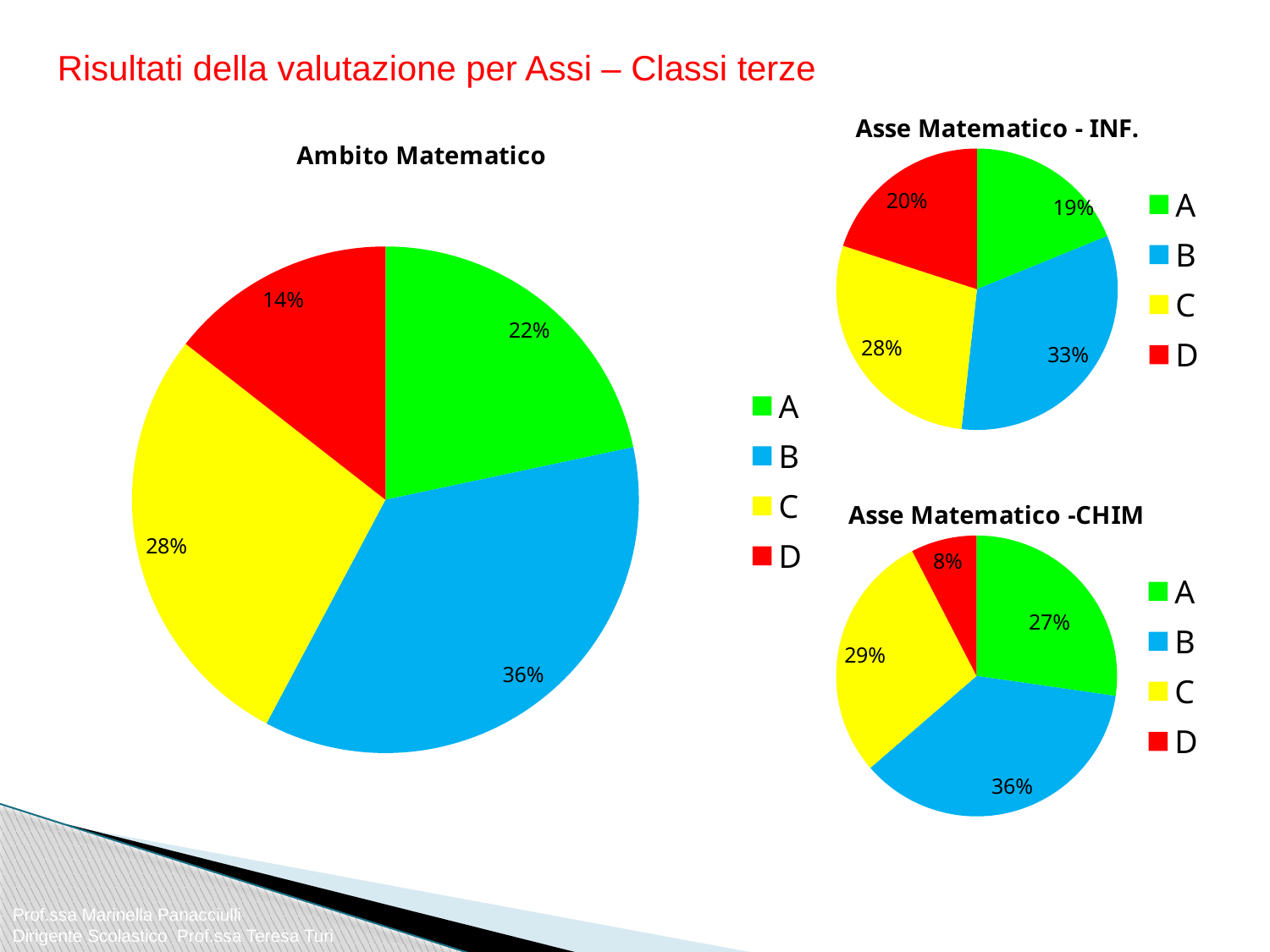
What kind of chart is 'Ambito Matematico'? Pie chart In the 'Asse Matematico - INF.' chart, what share does category D have? 20% In the 'Ambito Matematico' chart, which category has the smallest slice? D In the 'Ambito Matematico' chart, what colour is the slice for category C? Yellow How many categories does the legend of the 'Asse Matematico -CHIM' chart list? 4 In the 'Ambito Matematico' chart, what share does category B have? 36% In the 'Asse Matematico -CHIM' chart, what is the difference between the shares of B and C? 7% In the 'Asse Matematico -CHIM' chart, what share does category D have? 8% In the 'Asse Matematico - INF.' chart, which category has the largest slice? B In the 'Asse Matematico - INF.' chart, which is larger, the share of C or the share of A? C In the 'Asse Matematico -CHIM' chart, which category has the largest slice? B In the 'Ambito Matematico' chart, what is the difference between the shares of C and A? 6%